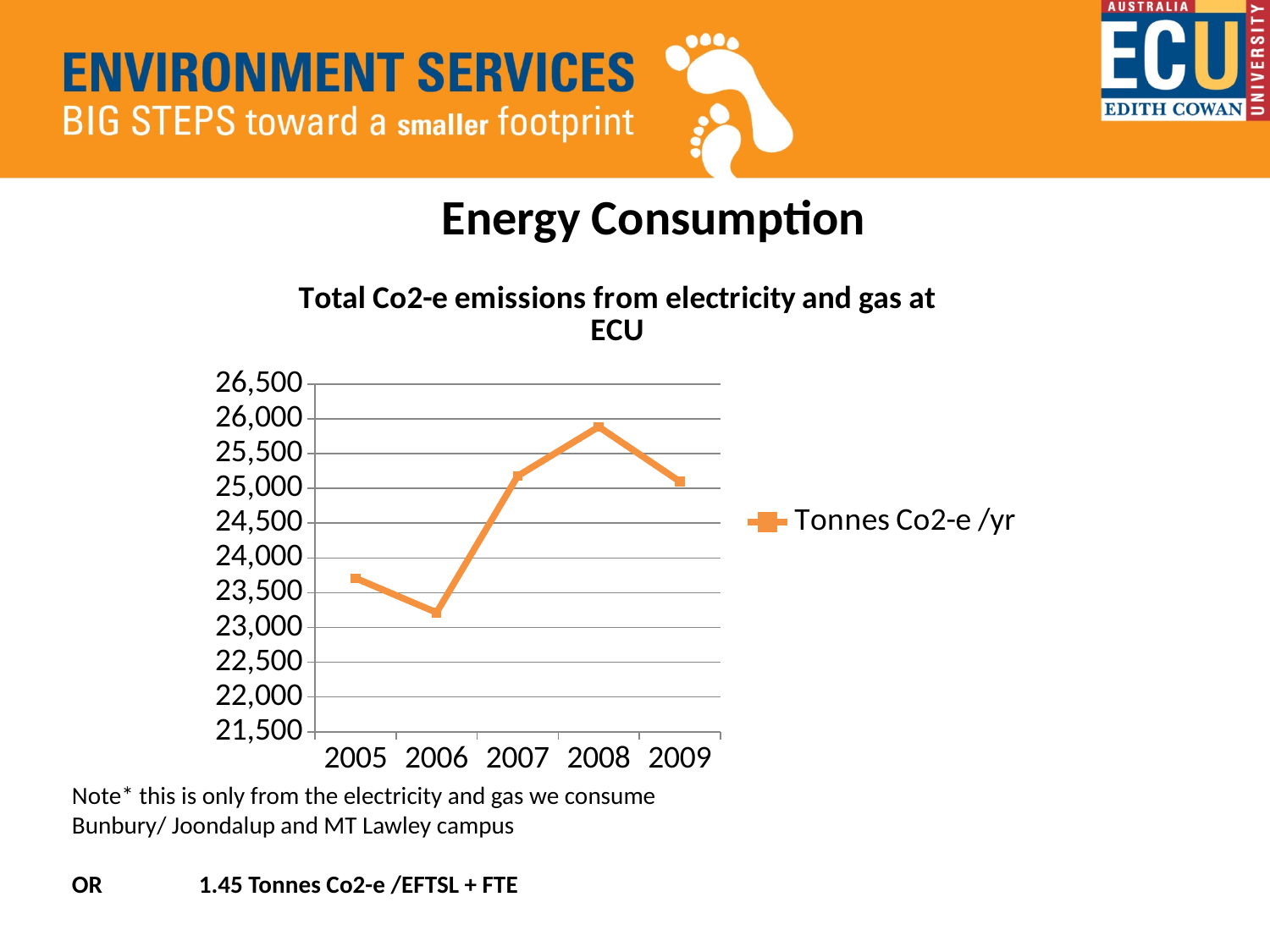
What kind of chart is used to show total Co2-e emissions from electricity and gas at ECU? line chart Is the value for 2006 greater or less than 23,500? less Is the value for 2009 greater or less than 24,500? greater Do the emissions rise or fall from 2006 to 2008? rise In which year were total Co2-e emissions lowest? 2006 Which year has the larger value, 2005 or 2007? 2007 How many series does the chart's legend list? 1 How many years are plotted on the x axis of the chart? 5 Which year has the larger value, 2008 or 2009? 2008 What is the name of the series shown in the chart's legend? Tonnes Co2-e /yr In which year were total Co2-e emissions highest? 2008 Is the value for 2008 greater or less than 25,500? greater